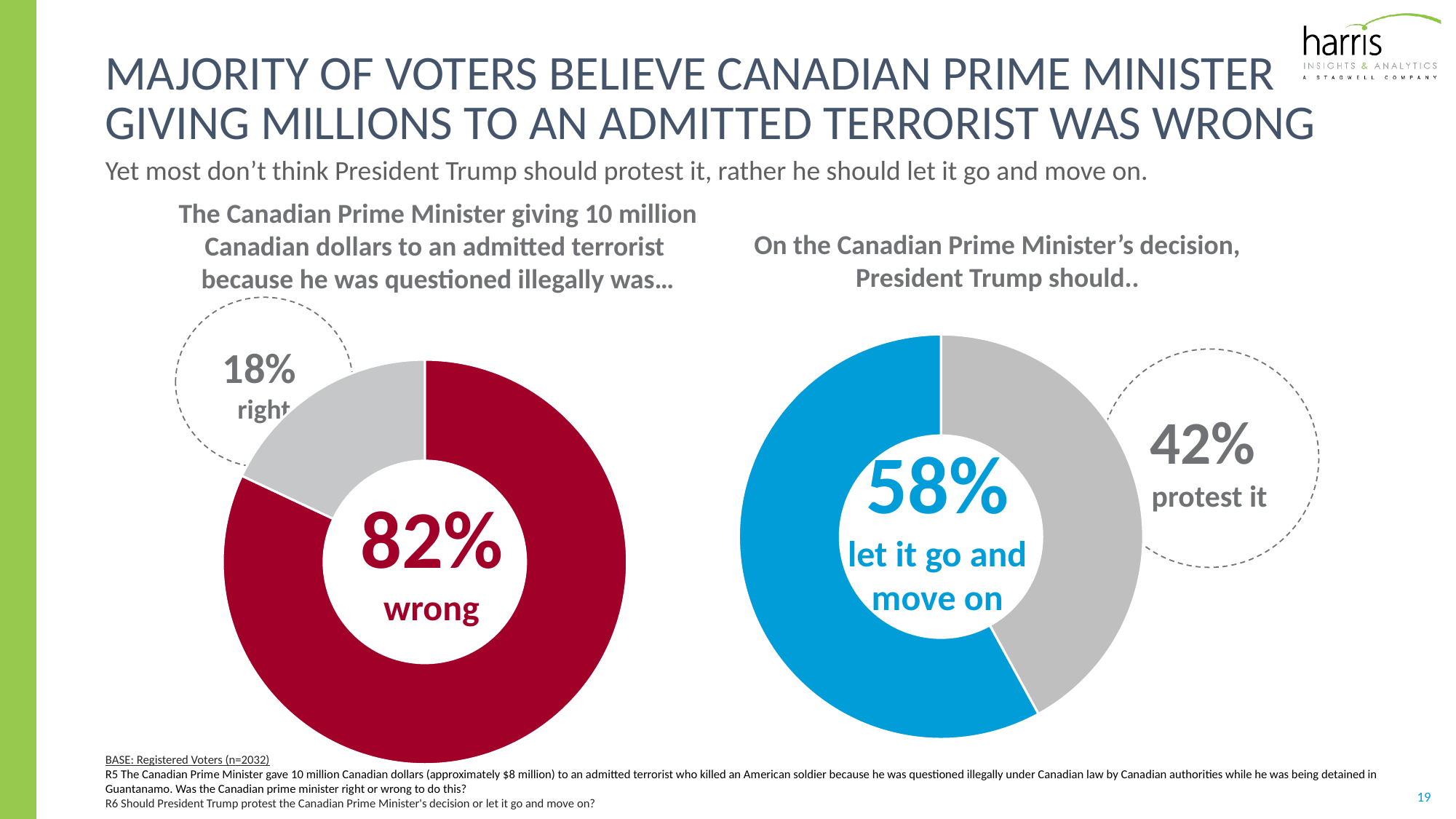
In the right chart, what percentage said President Trump should protest it? 42% Is the share for 'let it go and move on' in the right chart larger or smaller than the share for 'wrong' in the left chart? smaller In the left chart, what is the difference in percentage points between wrong and right? 64 What colour is the 'wrong' slice in the left chart? Red What type of chart is used on the left side of the slide? Donut (pie) chart In the right chart (On the Canadian Prime Minister's decision, President Trump should..), what percentage said he should let it go and move on? 58% In the left chart, what percentage of voters said the Canadian Prime Minister was right? 18% In the right chart, which response has the smaller share? protest it In the left chart, which response has the larger share: right or wrong? wrong In the left chart (The Canadian Prime Minister giving 10 million Canadian dollars to an admitted terrorist...), what percentage of voters said it was wrong? 82% How many slices does the right chart have? 2 In the right chart, what is the difference in percentage points between let it go and move on and protest it? 16